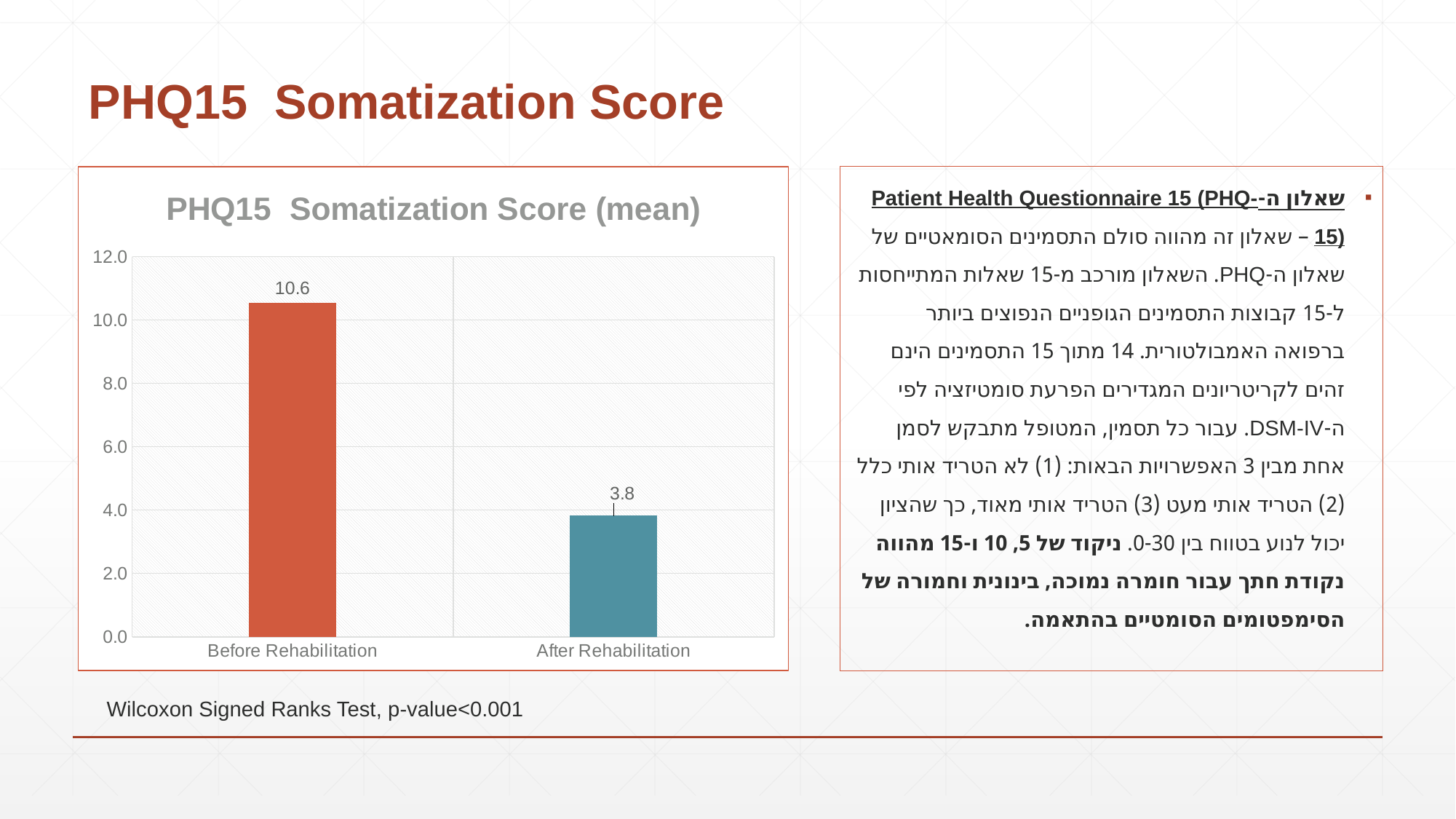
Is the value for Before Rehabilitation greater or less than 10.0? greater What is the mean PHQ15 Somatization Score for After Rehabilitation? 3.8 What kind of chart is shown on the slide? Bar chart Is the value for After Rehabilitation greater or less than 4.0? less Do the values rise or fall from Before Rehabilitation to After Rehabilitation? Fall What is the mean PHQ15 Somatization Score for Before Rehabilitation? 10.6 Which category has the highest mean PHQ15 Somatization Score? Before Rehabilitation How many categories are shown on the x axis of the chart? 2 What is the title of the chart? PHQ15 Somatization Score (mean) Which is larger, the mean score Before Rehabilitation or After Rehabilitation? Before Rehabilitation Which category has the lowest mean PHQ15 Somatization Score? After Rehabilitation What is the difference between the Before Rehabilitation and After Rehabilitation mean scores? 6.8